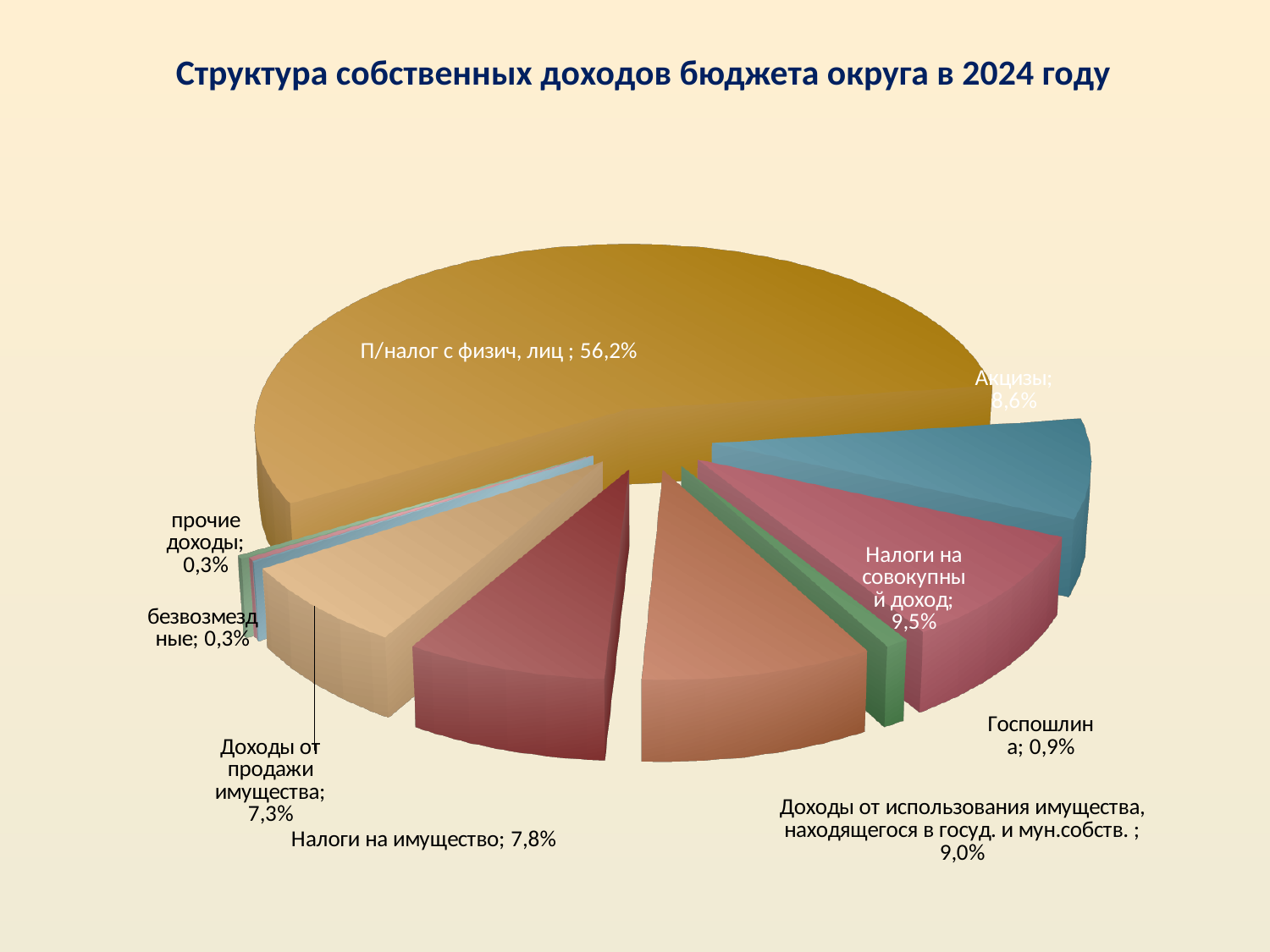
What value is shown for "безвозмездные"? 0,3% What is the value shown for "Налоги на совокупный доход"? 9,5% What is the value shown for "Госпошлина"? 0,9% What is the difference between the shares for "Налоги на имущество" and "Доходы от продажи имущества"? 0,5% Which is larger: the share for "Акцизы" or the share for "Налоги на имущество"? Акцизы What is the difference between the shares for "Налоги на совокупный доход" and "Доходы от использования имущества, находящегося в госуд. и мун.собств."? 0,5% What is the value shown for "Доходы от продажи имущества"? 7,3% What share of the pie is labelled "П/налог с физич. лиц"? 56,2% What kind of chart is shown on the slide? Pie chart Which category has the largest share of the pie? П/налог с физич. лиц How many categories (slices) does the pie chart have? 10 What is the title of the chart? Структура собственных доходов бюджета округа в 2024 году